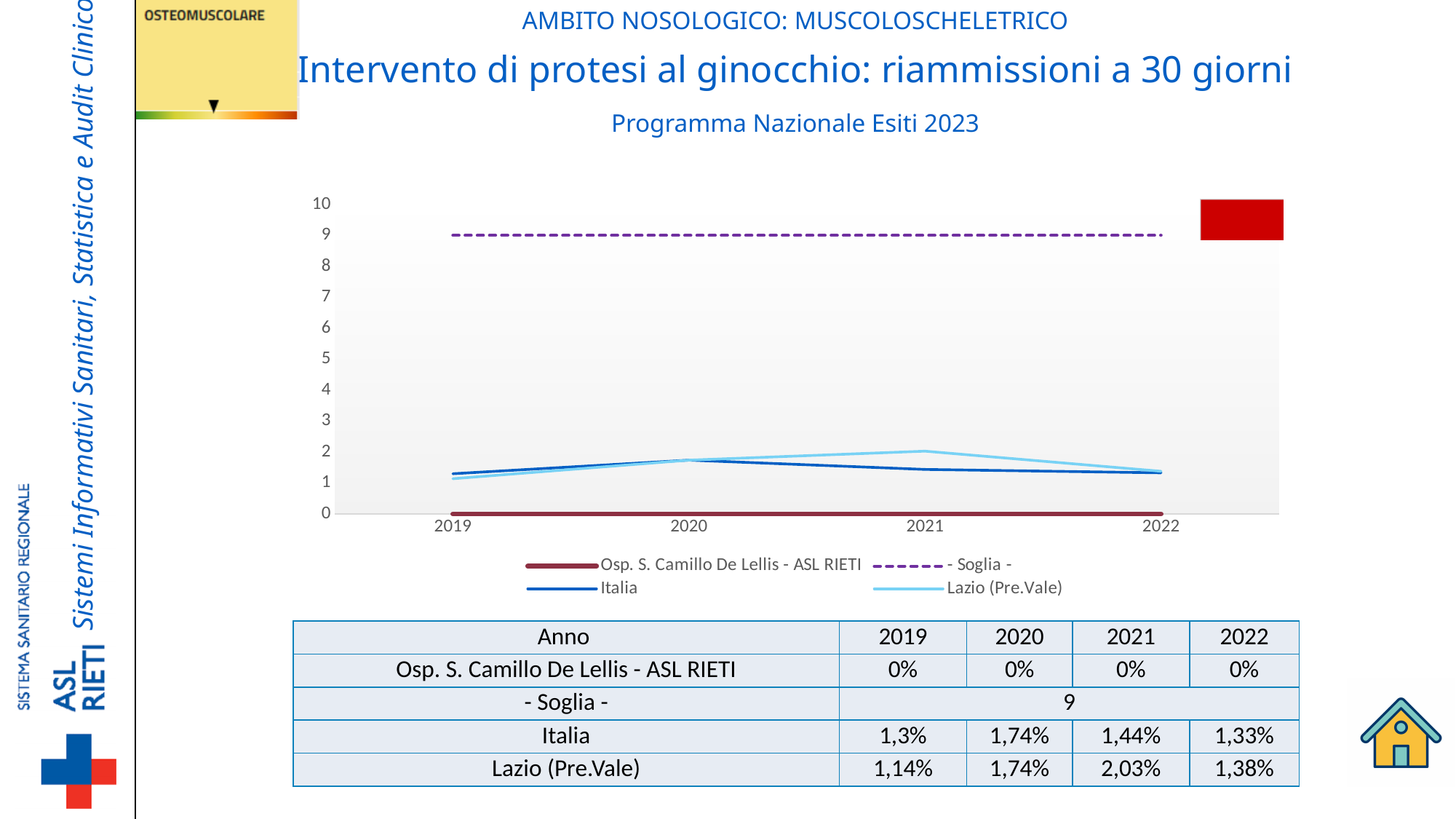
What is the value for Osp. S. Camillo De Lellis - ASL RIETI in 2022? 0% What is the value for Lazio (Pre.Vale) in 2021? 2,03% What kind of chart is shown on the slide? line chart What is the value of the Soglia line? 9 Is the Soglia line greater or less than 5 on the y axis? greater How many years are shown on the x axis of the chart? 4 Which is larger in 2019, the value for Italia or the value for Lazio (Pre.Vale)? Italia In which year is the Lazio (Pre.Vale) value lowest? 2019 Does the Italia line rise or fall from 2020 to 2022? fall How many series does the chart legend list? 4 What is the value for Italia in 2020? 1,74% In which year is the Lazio (Pre.Vale) value highest? 2021